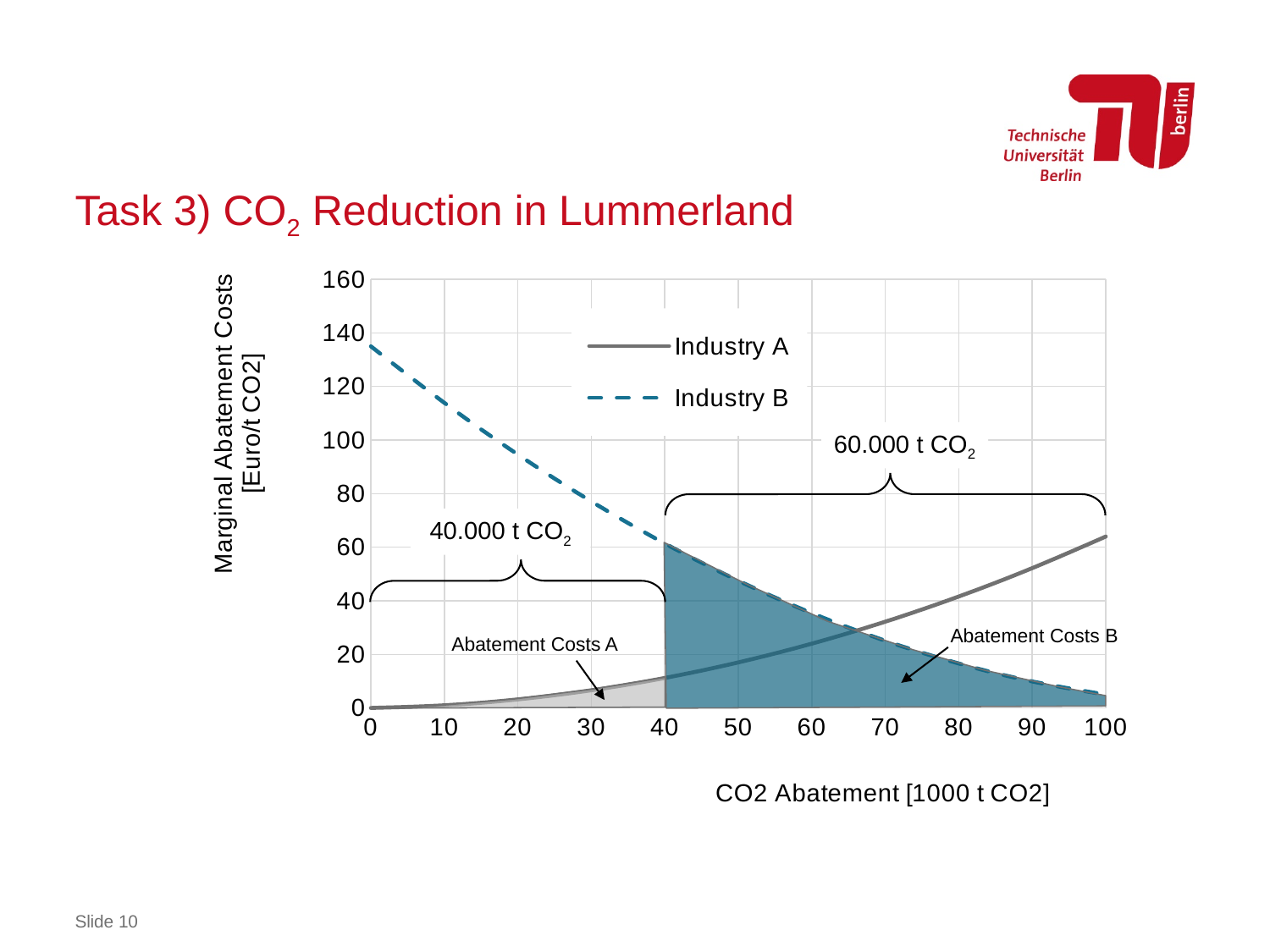
What is the label of the x axis? CO2 Abatement [1000 t CO2] Do the values for Industry B rise or fall as CO2 abatement increases along the x axis? fall At 20 on the x axis, which series has the higher value, Industry A or Industry B? Industry B Do the values for Industry A rise or fall as CO2 abatement increases along the x axis? rise Is the value for Industry B at 100 on the x axis greater or less than 20? less Which two series are listed in the legend? Industry A and Industry B Is the value for Industry B at 0 on the x axis greater or less than 120? greater At 90 on the x axis, which series has the higher value, Industry A or Industry B? Industry A What kind of chart is shown on the slide? line chart How many series does the legend list? 2 Is the value for Industry A at 100 on the x axis greater or less than 40? greater